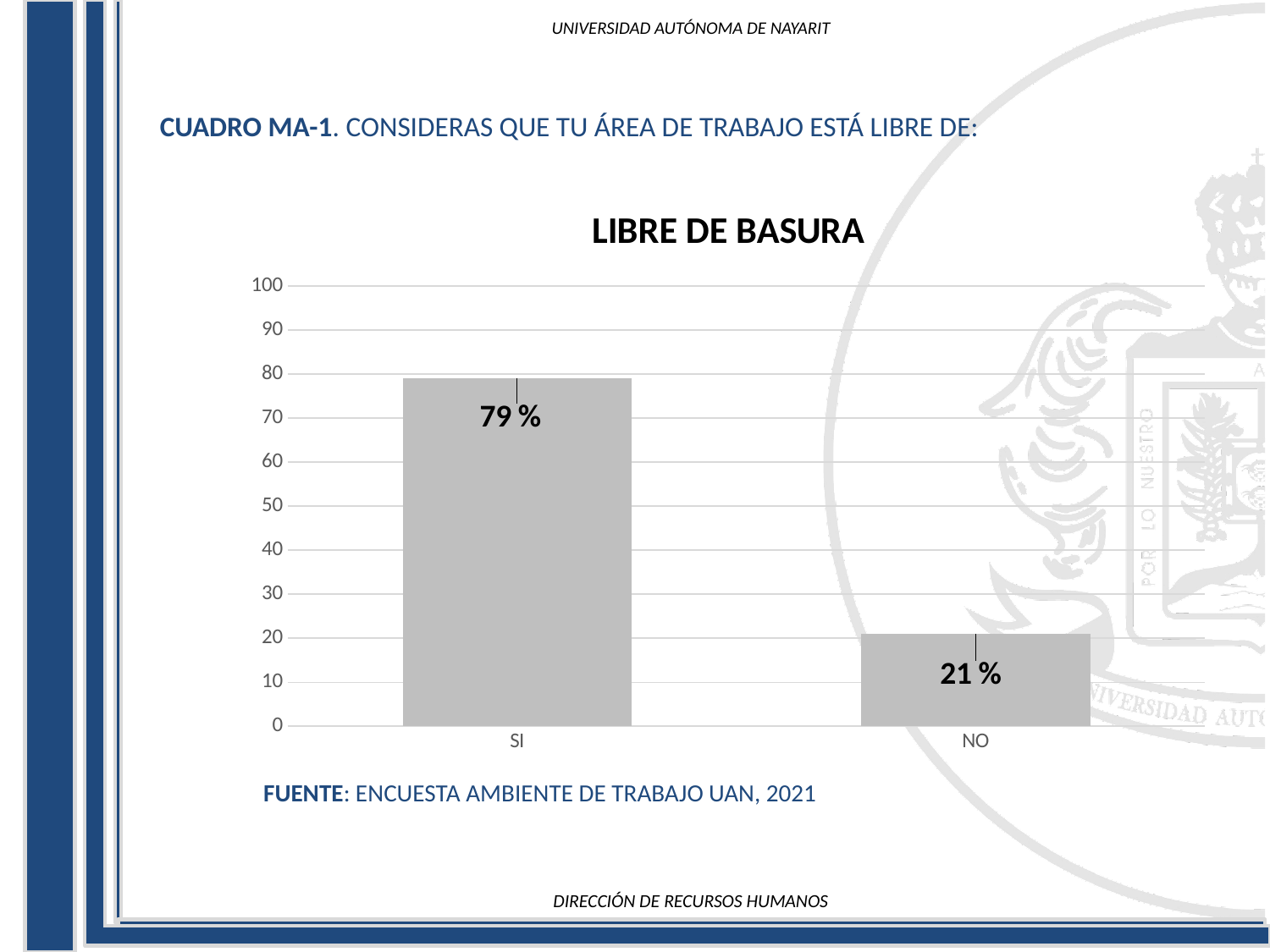
What is the maximum value shown on the y axis? 100 Is the value for SI greater or less than 70? greater Which category has the lowest value? NO What is the title of the chart? LIBRE DE BASURA What is the value for SI? 79 % What kind of chart is shown? bar chart Which category has the highest value? SI What is the difference between the values for SI and NO? 58 % Is the value for NO greater or less than 30? less How many categories are shown on the x axis? 2 What is the value for NO? 21 % Which is larger, the value for SI or the value for NO? SI